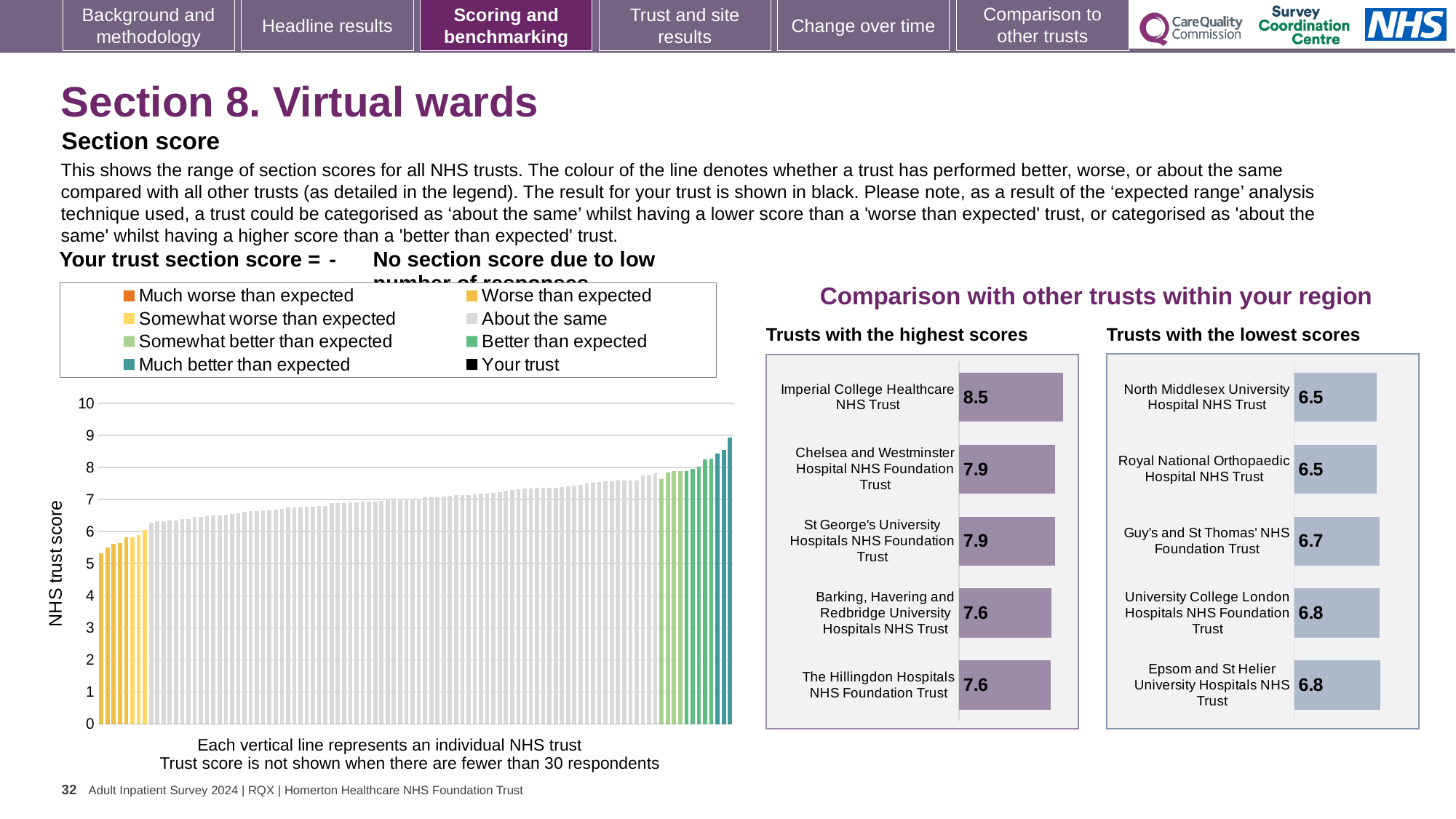
How many trusts are shown in the 'Trusts with the lowest scores' chart? 5 In the main NHS trust score chart, do the bars rise or fall from left to right? Rise What kind of chart is the main chart showing the range of NHS trust scores? Bar chart How many entries does the legend of the main NHS trust score chart list? 8 Which is larger: the score for Chelsea and Westminster Hospital NHS Foundation Trust in the highest-scores chart or the score for Guy's and St Thomas' NHS Foundation Trust in the lowest-scores chart? Chelsea and Westminster Hospital NHS Foundation Trust In the 'Trusts with the lowest scores' chart, what is the score for Guy's and St Thomas' NHS Foundation Trust? 6.7 In the 'Trusts with the highest scores' chart, which trust has the highest score? Imperial College Healthcare NHS Trust In the 'Trusts with the highest scores' chart, what is the score for Imperial College Healthcare NHS Trust? 8.5 In the 'Trusts with the lowest scores' chart, what is the score for Epsom and St Helier University Hospitals NHS Trust? 6.8 In the 'Trusts with the highest scores' chart, what is the difference between the scores of Imperial College Healthcare NHS Trust and The Hillingdon Hospitals NHS Foundation Trust? 0.9 In the 'Trusts with the lowest scores' chart, what is the difference between the scores of University College London Hospitals NHS Foundation Trust and North Middlesex University Hospital NHS Trust? 0.3 In the 'Trusts with the highest scores' chart, what is the score for Barking, Havering and Redbridge University Hospitals NHS Trust? 7.6